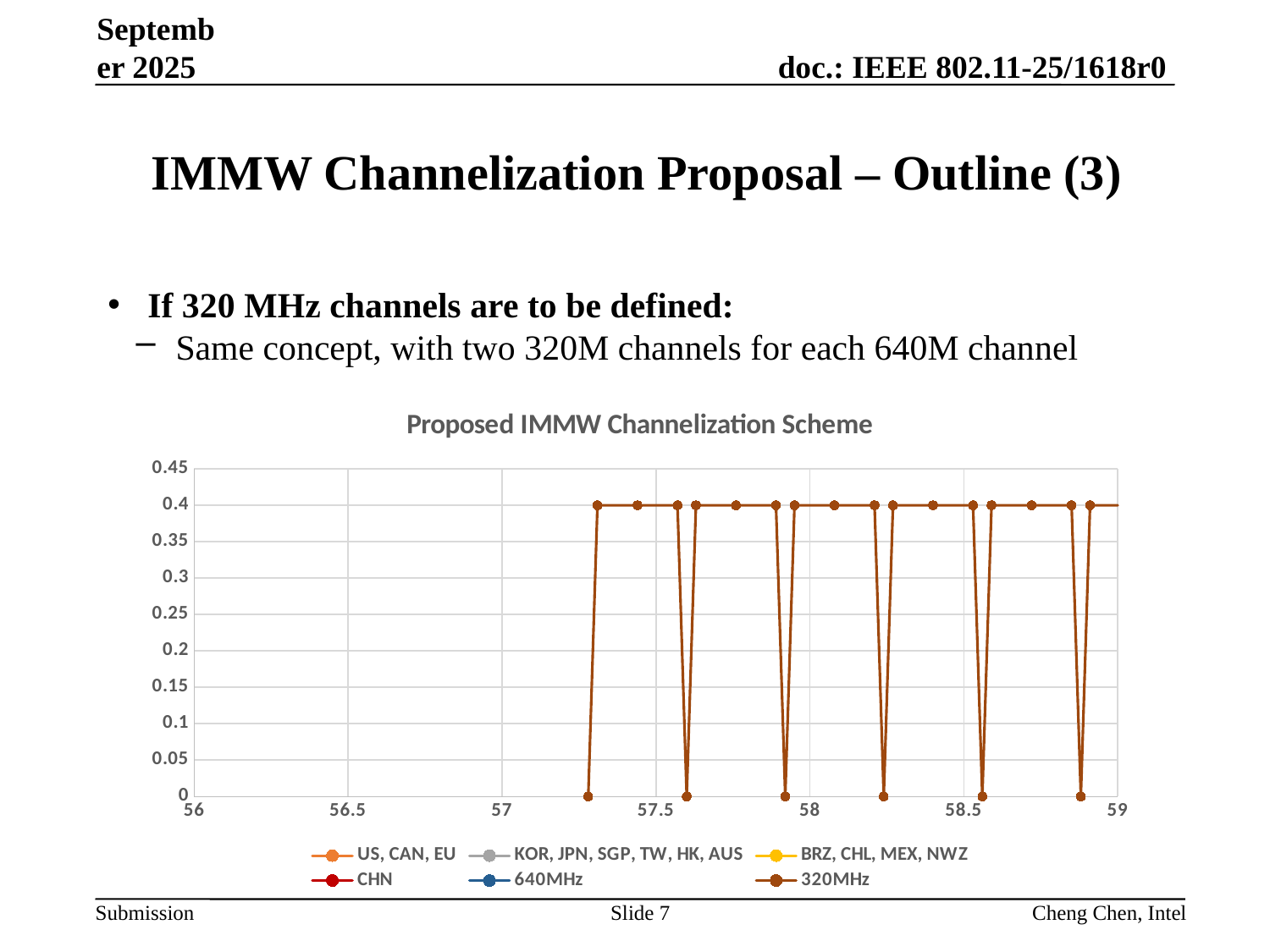
Is the value of the plotted line at x = 58 greater or less than 0.2? greater Is the plateau value of the plotted line greater or less than 0.3? greater What is the lowest value the plotted line drops to? 0 Which legend entry is listed last in the chart legend? 320MHz How many series does the chart legend list? 6 How many plotted points lie on the 0 line of the y axis? 6 What is the title of the chart? Proposed IMMW Channelization Scheme What is the highest value the plotted line reaches on the y axis? 0.4 What kind of chart is shown on the slide? line chart